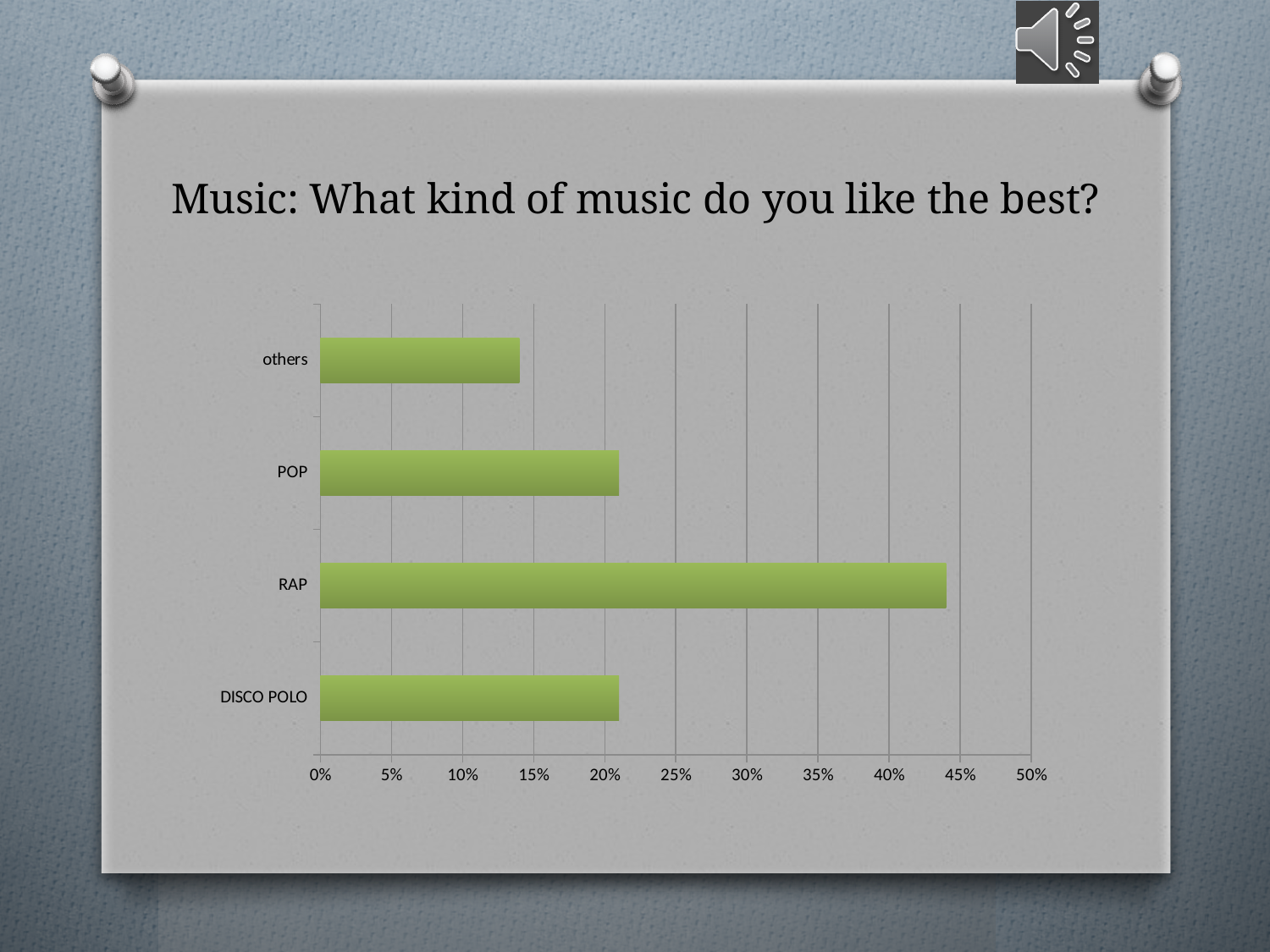
Is the value for RAP greater or less than 40%? greater Is the value for RAP greater or less than 45%? less Is the value for others greater or less than 15%? less What kind of chart is shown on the slide? bar chart Which kind of music has the lowest value? others What is the title of the slide containing the chart? Music: What kind of music do you like the best? How many kinds of music are shown on the chart? 4 Which kind of music has the highest value? RAP Which is larger, the value for RAP or the value for POP? RAP